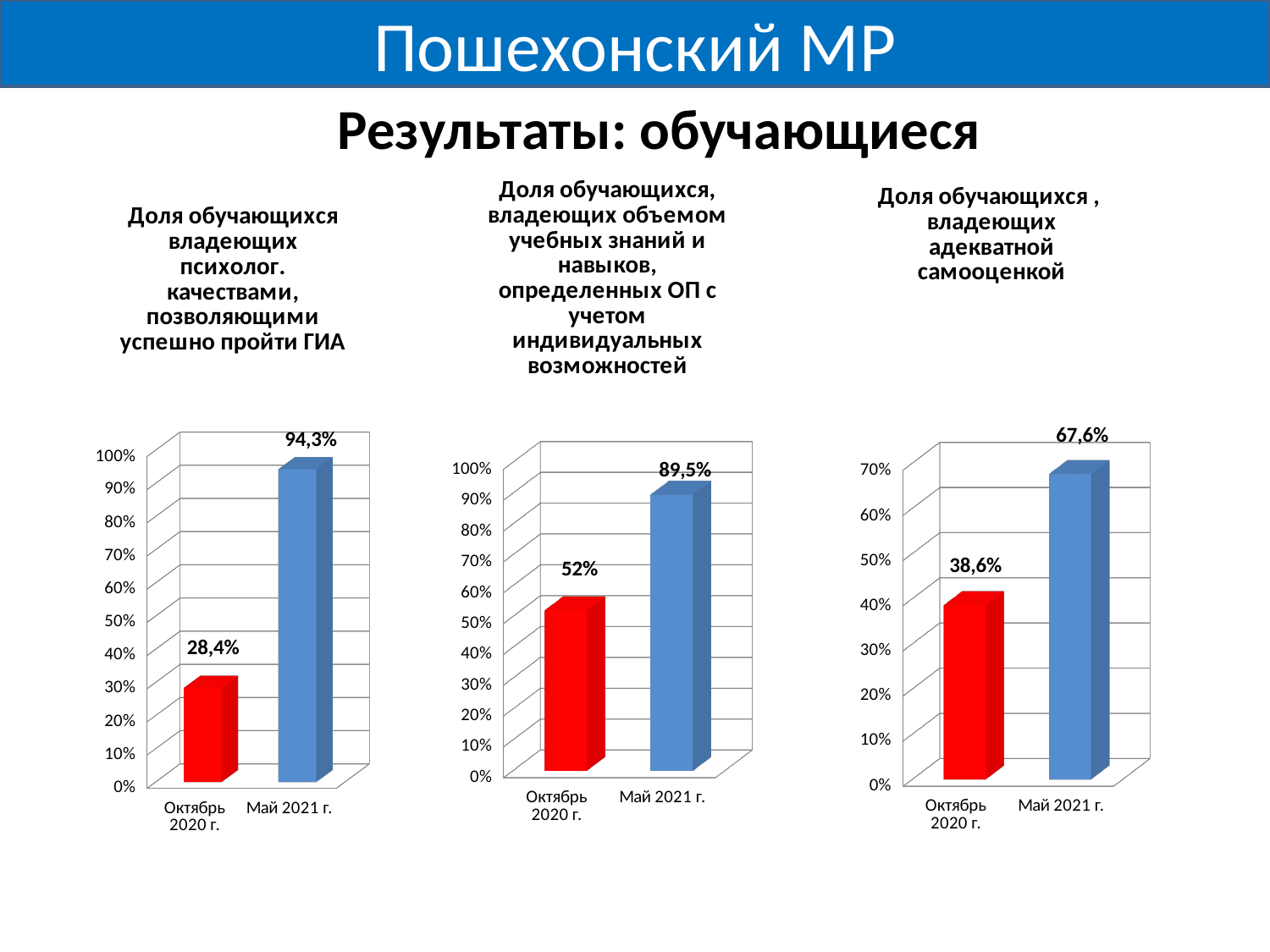
In the middle chart (Доля обучающихся, владеющих объемом учебных знаний и навыков...), what is the value for Октябрь 2020 г.? 52% In the right chart (Доля обучающихся, владеющих адекватной самооценкой), what is the value for Май 2021 г.? 67,6% In the left chart (Доля обучающихся владеющих психолог. качествами, позволяющими успешно пройти ГИА), what is the value for Май 2021 г.? 94,3% What type of chart is used for the left chart? bar chart In the right chart, which period has the higher value, Октябрь 2020 г. or Май 2021 г.? Май 2021 г. How many bars are shown in the right chart? 2 In the left chart (Доля обучающихся владеющих психолог. качествами, позволяющими успешно пройти ГИА), what is the value for Октябрь 2020 г.? 28,4% In the middle chart (Доля обучающихся, владеющих объемом учебных знаний и навыков...), what is the value for Май 2021 г.? 89,5% In the middle chart, do the values rise or fall from Октябрь 2020 г. to Май 2021 г.? rise In the left chart, by how many percentage points did the value increase from Октябрь 2020 г. to Май 2021 г.? 65,9 In the right chart (Доля обучающихся, владеющих адекватной самооценкой), what is the value for Октябрь 2020 г.? 38,6% In the middle chart, what is the difference between the Май 2021 г. and Октябрь 2020 г. values? 37,5